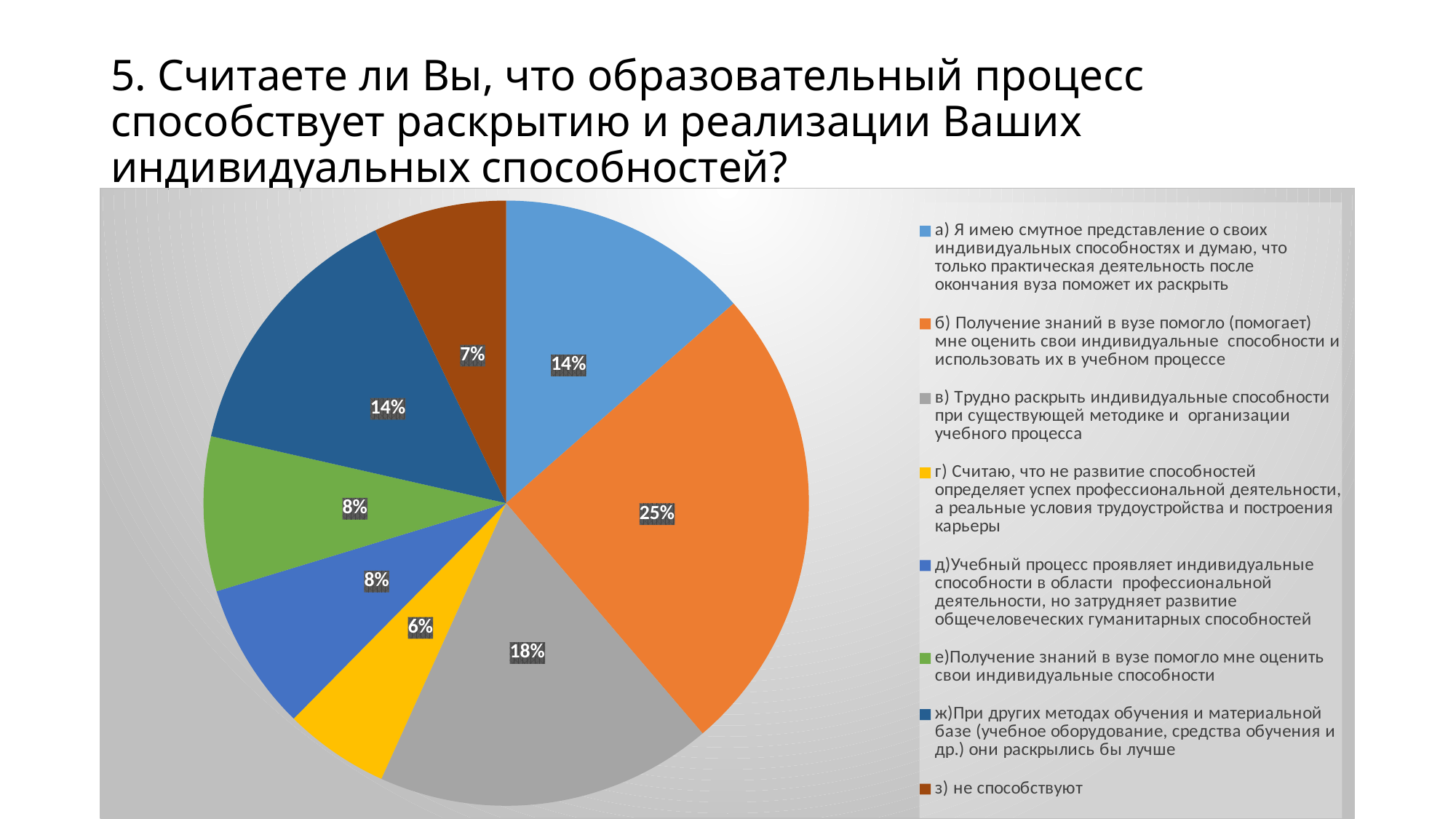
What share of the pie is option в) (Трудно раскрыть индивидуальные способности при существующей методике и организации учебного процесса)? 18% Which option has the largest share of the pie? б) Получение знаний в вузе помогло (помогает) мне оценить свои индивидуальные способности и использовать их в учебном процессе What share of the pie is option б) (Получение знаний в вузе помогло мне оценить свои индивидуальные способности и использовать их в учебном процессе)? 25% What share of the pie is option г) (Считаю, что не развитие способностей определяет успех профессиональной деятельности)? 6% What colour is the slice for option з) (не способствуют)? brown What is the difference in percentage points between option б) (25%) and option в) (18%)? 7 How many slices does the pie chart have? 8 How many entries does the legend list? 8 Which option has the smallest share of the pie? г) Считаю, что не развитие способностей определяет успех профессиональной деятельности, а реальные условия трудоустройства и построения карьеры Which is larger: the share for option ж) (При других методах обучения и материальной базе) or the share for option з) (не способствуют)? ж) При других методах обучения и материальной базе What kind of chart is shown on the slide? pie chart